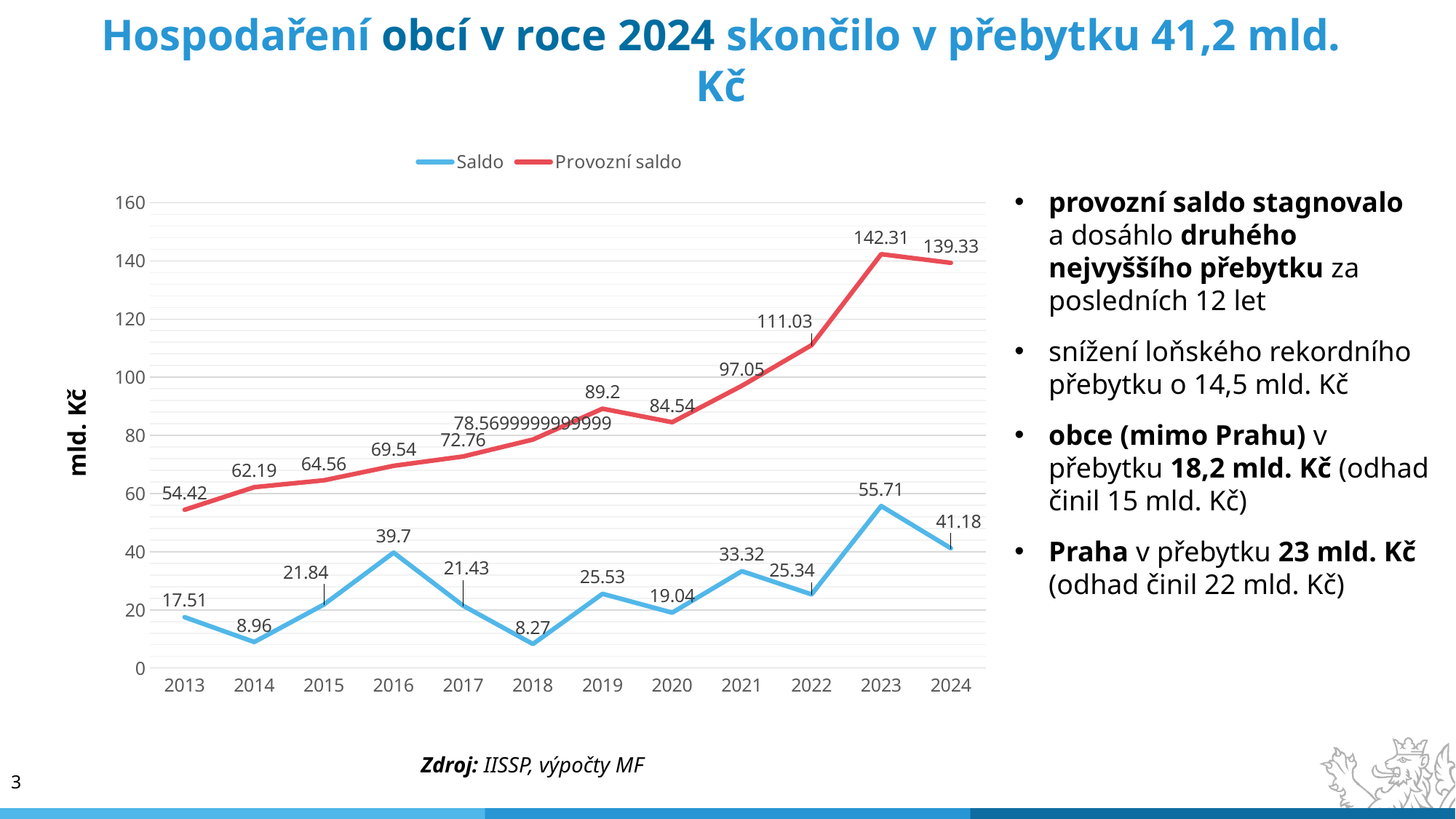
What is the value of Saldo in 2024? 41.18 What is the value of Provozní saldo in 2023? 142.31 How many years are plotted on the x axis? 12 In which year is Provozní saldo highest? 2023 What is the difference between Provozní saldo in 2023 and in 2024? 2.98 What is the value of Saldo in 2018? 8.27 What type of chart is shown on the slide? line chart How many series does the legend list? 2 What is the label on the vertical axis? mld. Kč In which year is Saldo lowest? 2018 Is the value of Provozní saldo in 2022 greater or less than 100? greater Which is larger: Saldo in 2016 or Saldo in 2021? Saldo in 2016